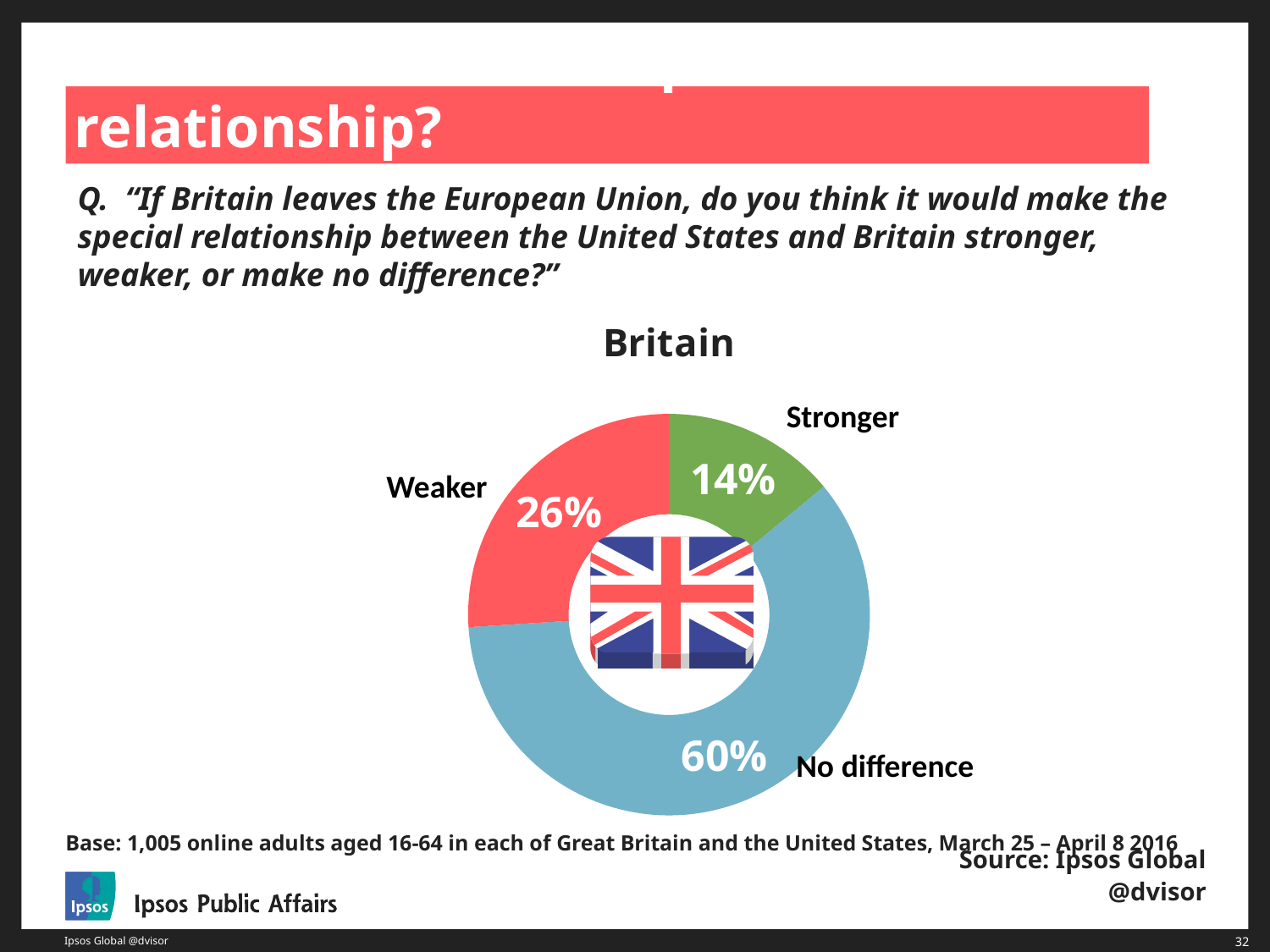
Which response has the smallest share in the Britain chart? Stronger What is the title of the chart? Britain Which response has the largest share in the Britain chart? No difference What kind of chart is shown on the slide? Doughnut (pie) chart How many response categories are shown in the chart? 3 What percentage of respondents in Britain said leaving the EU would make the special relationship stronger? 14% What percentage of respondents in Britain said leaving the EU would make the special relationship weaker? 26% What colour is the 'No difference' segment of the chart? Blue What is the difference in percentage points between the 'Weaker' and 'Stronger' shares? 12 percentage points What percentage of respondents in Britain said leaving the EU would make no difference to the special relationship? 60% Which is larger, the share for 'Weaker' or the share for 'Stronger'? Weaker What is the difference in percentage points between the 'No difference' and 'Weaker' shares? 34 percentage points